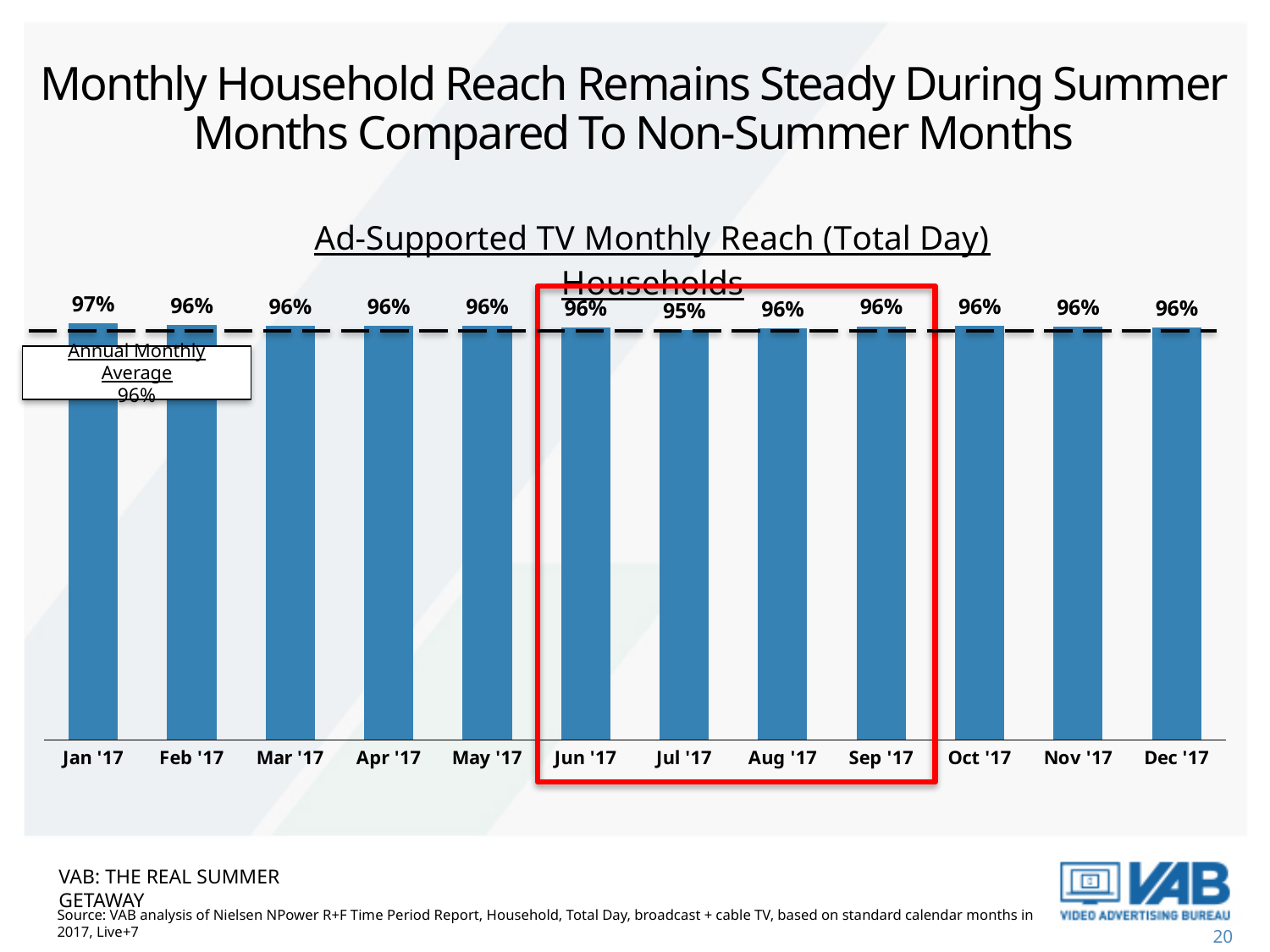
What is the difference between the values for Jan '17 and Jul '17? 2% Which is larger, the value for Jan '17 or the value for Jul '17? Jan '17 What is the value for Jul '17? 95% What is the value for Sep '17? 96% What is the value for Jan '17? 97% Which month has the highest value? Jan '17 Which months are enclosed by the red box? Jun '17, Jul '17, Aug '17, Sep '17 Which month has the lowest value? Jul '17 What kind of chart is this? Bar chart How many months are shown on the x axis? 12 What is the Annual Monthly Average shown by the dashed line? 96% What is the value for Dec '17? 96%